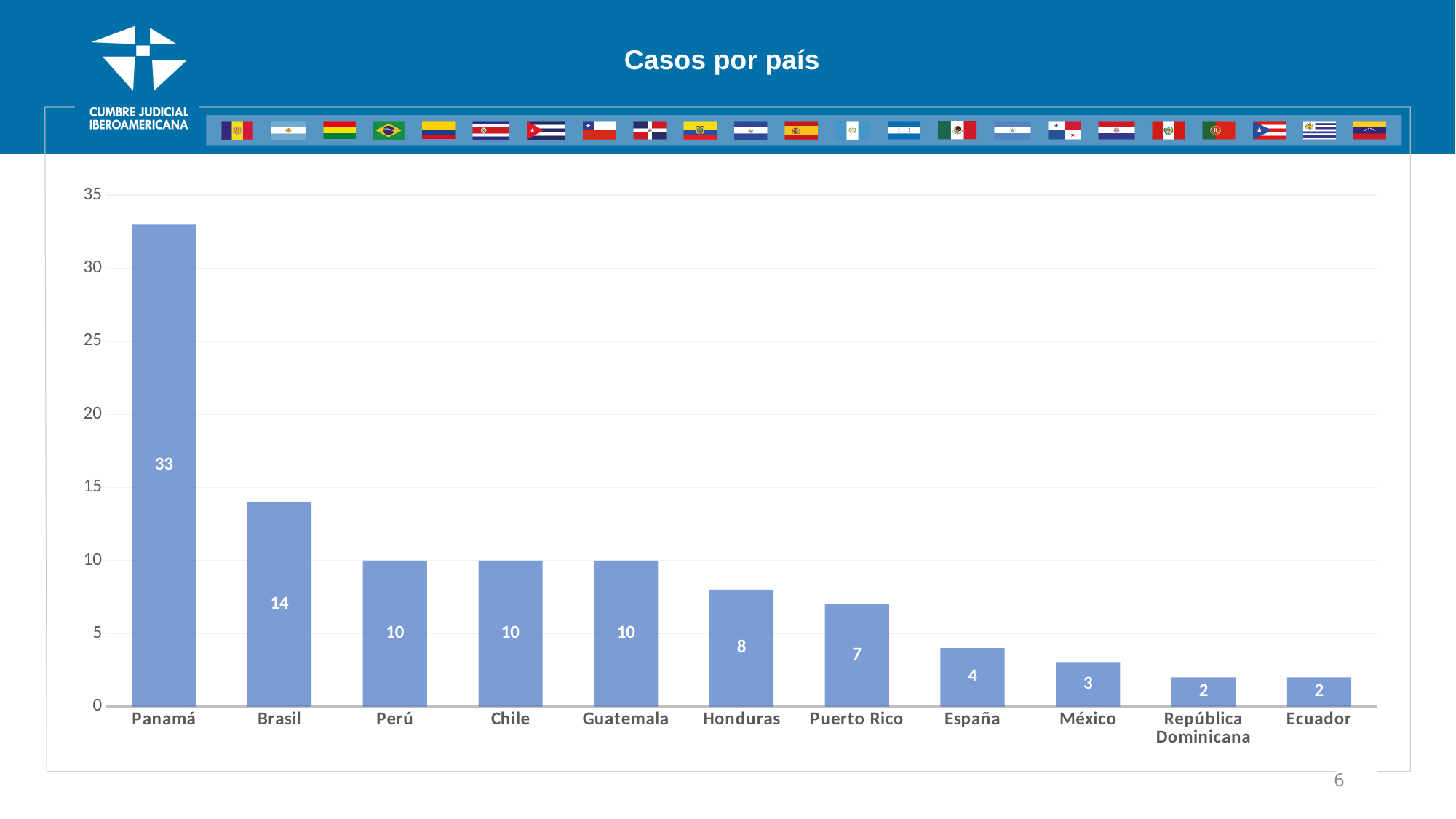
What is the title of the chart? Casos por país Is the value for Panamá greater or less than 30? greater Which is larger, the value for Brasil or the value for Honduras? Brasil What kind of chart is shown on the slide? bar chart What is the difference between the values for Puerto Rico and España? 3 How many countries are shown on the x axis? 11 What is the difference between the values for Panamá and Brasil? 19 Do the values rise or fall from left to right along the x axis? fall What is the value for Panamá? 33 What is the value for República Dominicana? 2 What is the value for Honduras? 8 Which country has the highest value? Panamá